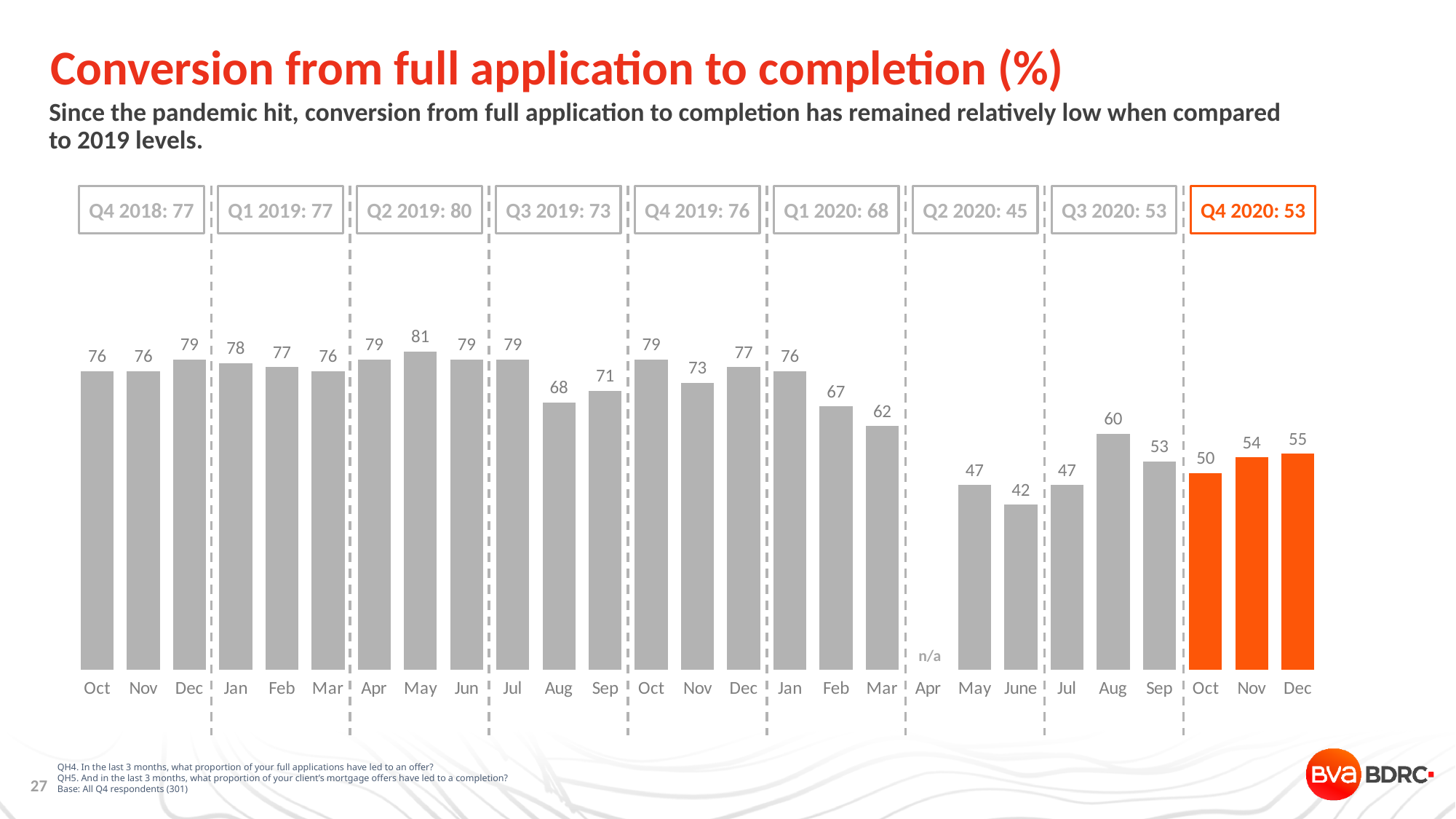
What is the value shown for Dec 2020, the last bar on the chart? 55 Which month has the highest bar on the chart? May 2019 Which quarter's box is highlighted in orange? Q4 2020 Which is larger: the value for Mar 2020 or the value for Feb 2020? Feb 2020 What is the conversion value for June 2020 (in the Q2 2020 section)? 42 What is the difference between the Aug 2020 value and the Sep 2020 value? 7 What is the conversion value for May 2019 (in the Q2 2019 section)? 81 What quarterly figure is shown in the box for Q2 2020? 45 Which month has the lowest bar on the chart? June 2020 Do the values rise or fall from Oct 2020 to Dec 2020? Rise Which month is marked n/a with no bar? Apr 2020 What type of chart is shown on the slide? Bar chart